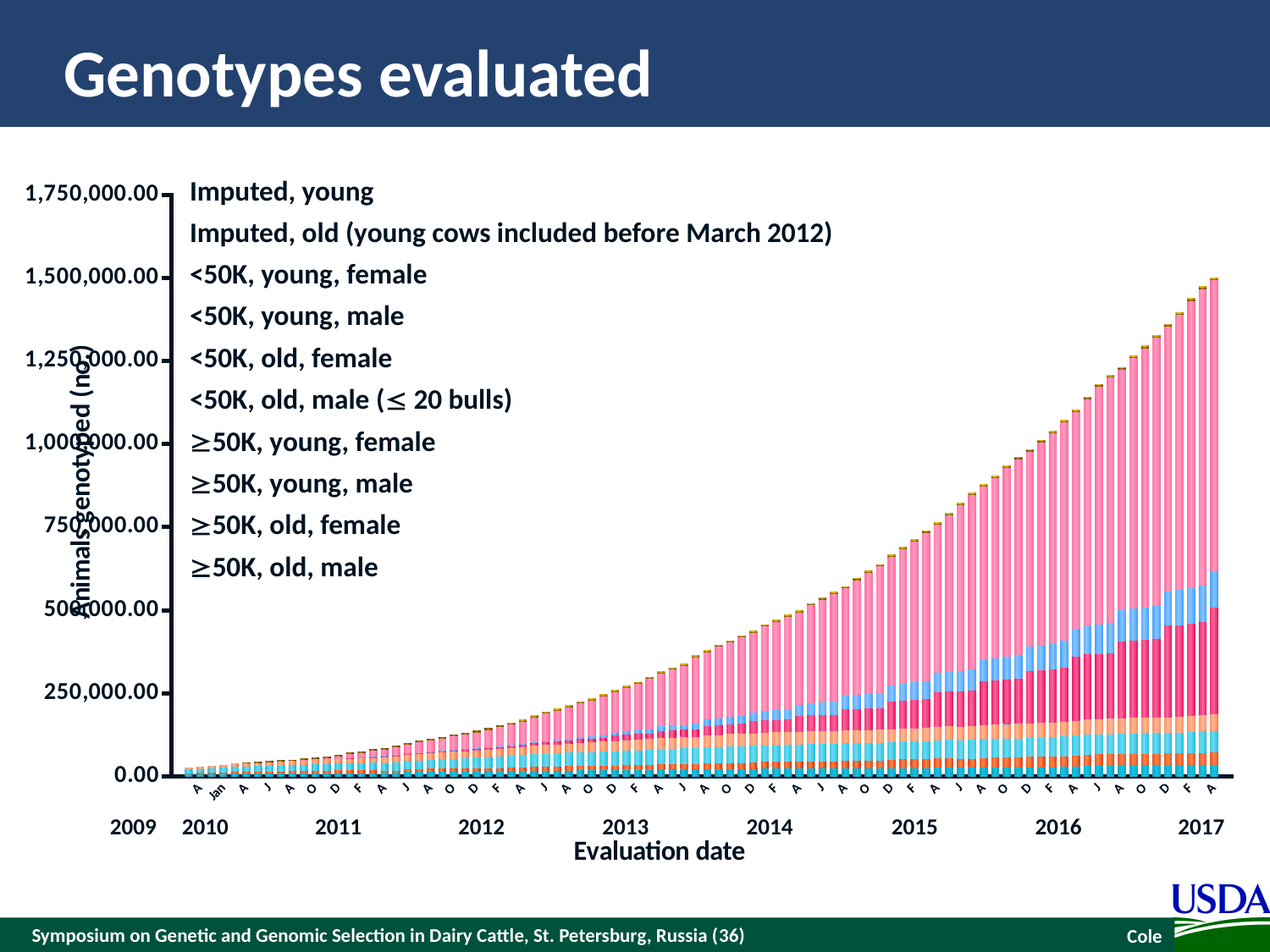
Is the total for the last bar in 2017 greater or less than 1,750,000.00? less Do the total bar heights rise or fall from 2009 to 2017 along the x axis? rise What is the title of the slide's chart? Genotypes evaluated Is the total for the first bar of 2012 greater or less than 250,000.00? less What is the label of the x axis? Evaluation date What kind of chart is shown on the slide? stacked bar chart In which year do the shortest bars appear? 2009 Is the total for the first bar of 2014 greater or less than 500,000.00? less In which year does the tallest bar appear? 2017 How many series does the legend list? 10